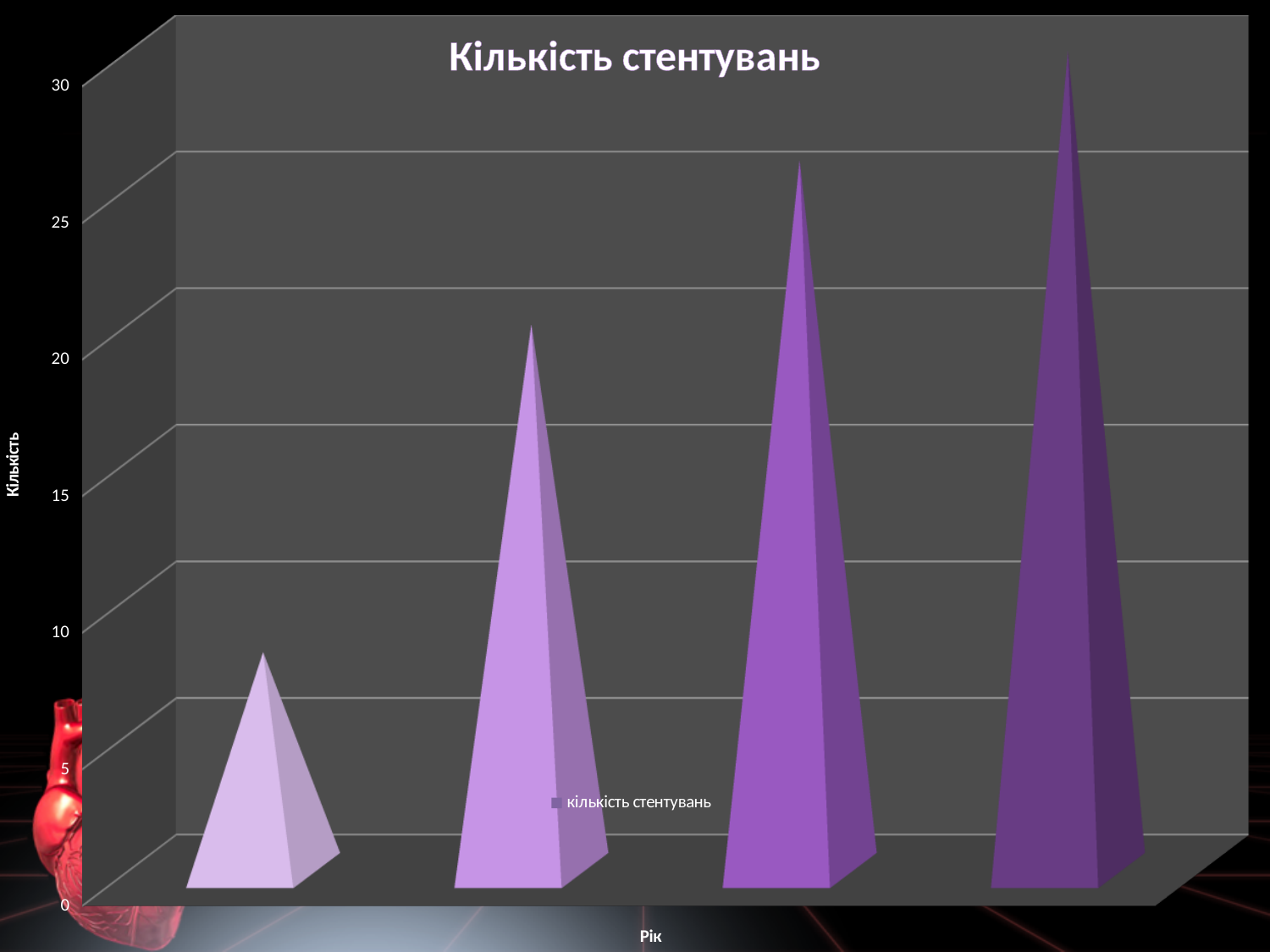
Do the values rise or fall from left to right along the x axis? rise Which bar is the highest: the leftmost, second, third or rightmost? rightmost What is the title of the chart? Кількість стентувань How many bars are plotted in the chart? 4 Is the value of the third bar from the left greater or less than 20? greater What is the legend entry shown in the chart? кількість стентувань What kind of chart is shown on the slide? bar chart How many series does the legend list? 1 Is the value of the rightmost bar greater or less than 25? greater Which bar is the lowest: the leftmost, second, third or rightmost? leftmost Which is larger, the second bar from the left or the third bar from the left? the third bar Is the value of the leftmost bar greater or less than 15? less